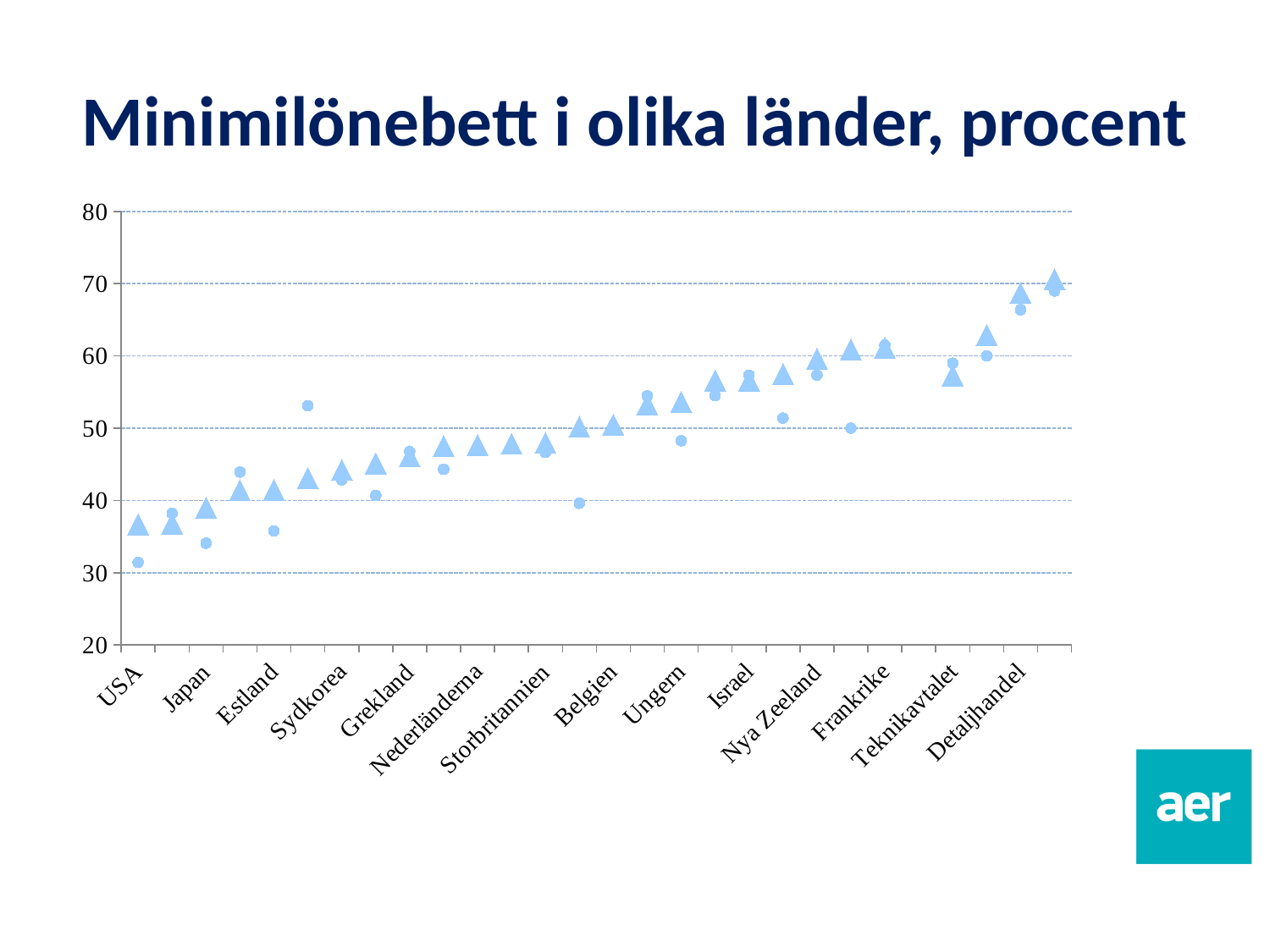
Is the circle-marker value for Israel greater or less than 50? greater Is the circle-marker value for Ungern greater or less than 50? less Is the circle-marker value for Sydkorea greater or less than 50? less Which labelled category has the lowest plotted values? USA What is the title of the chart? Minimilönebett i olika länder, procent Which labelled category has the highest plotted values? Detaljhandel Do the plotted values generally rise or fall from left to right along the x axis? rise How many category labels are shown on the x axis? 14 What kind of chart is shown on the slide? scatter chart